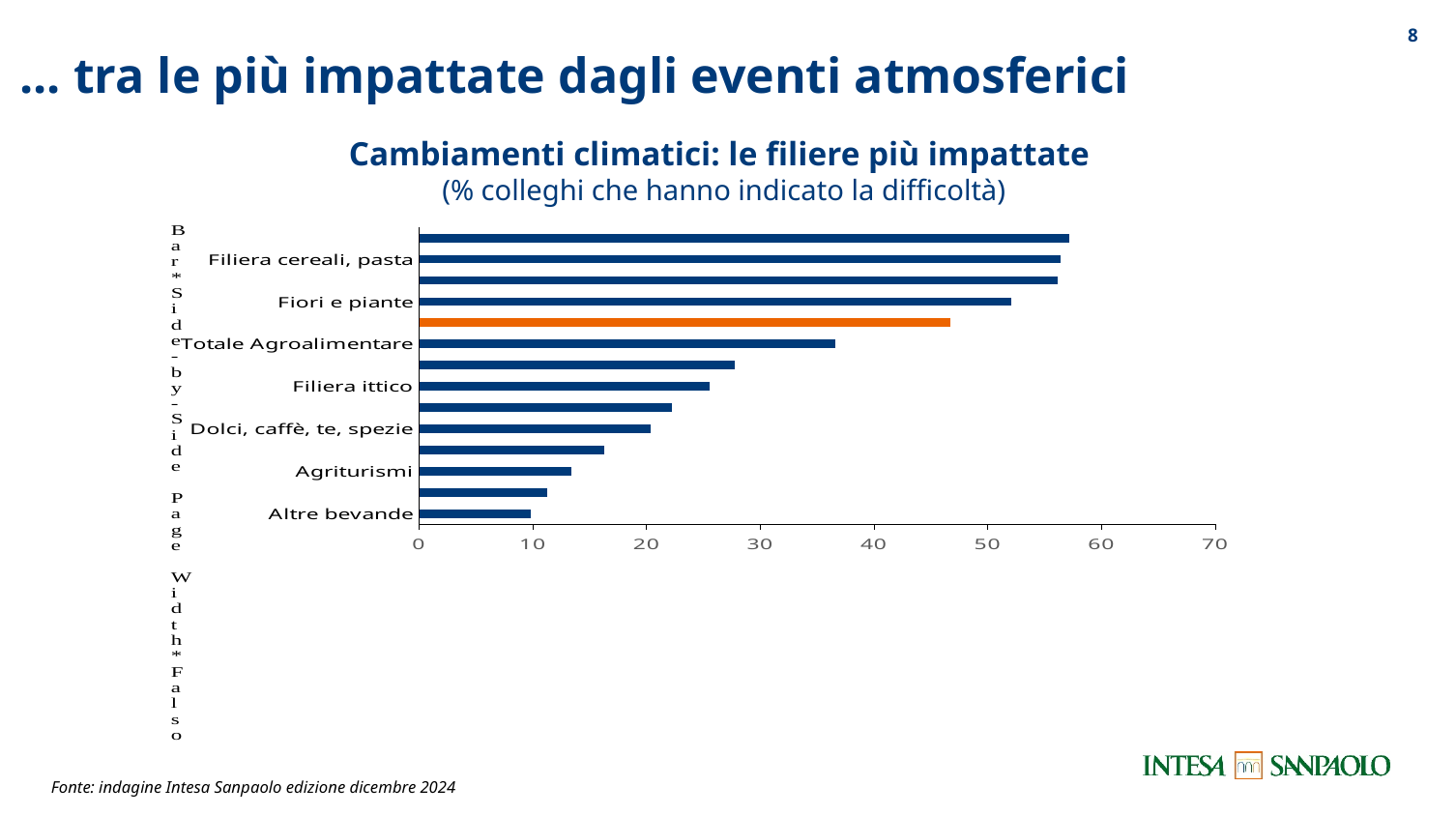
Do the bar values increase or decrease going from the top of the chart to the bottom? Decrease Which has a larger value, Fiori e piante or Filiera ittico? Fiori e piante Is the value of the orange bar greater or less than 40? greater Is the value for Fiori e piante greater or less than 50? greater What colour is the single highlighted bar in the chart? Orange How many bars are plotted in the chart? 14 Is the value for Filiera ittico greater or less than 30? less What kind of chart is shown on the slide? Bar chart What is the title of the chart? Cambiamenti climatici: le filiere più impattate Which has a larger value, Filiera cereali, pasta or Altre bevande? Filiera cereali, pasta